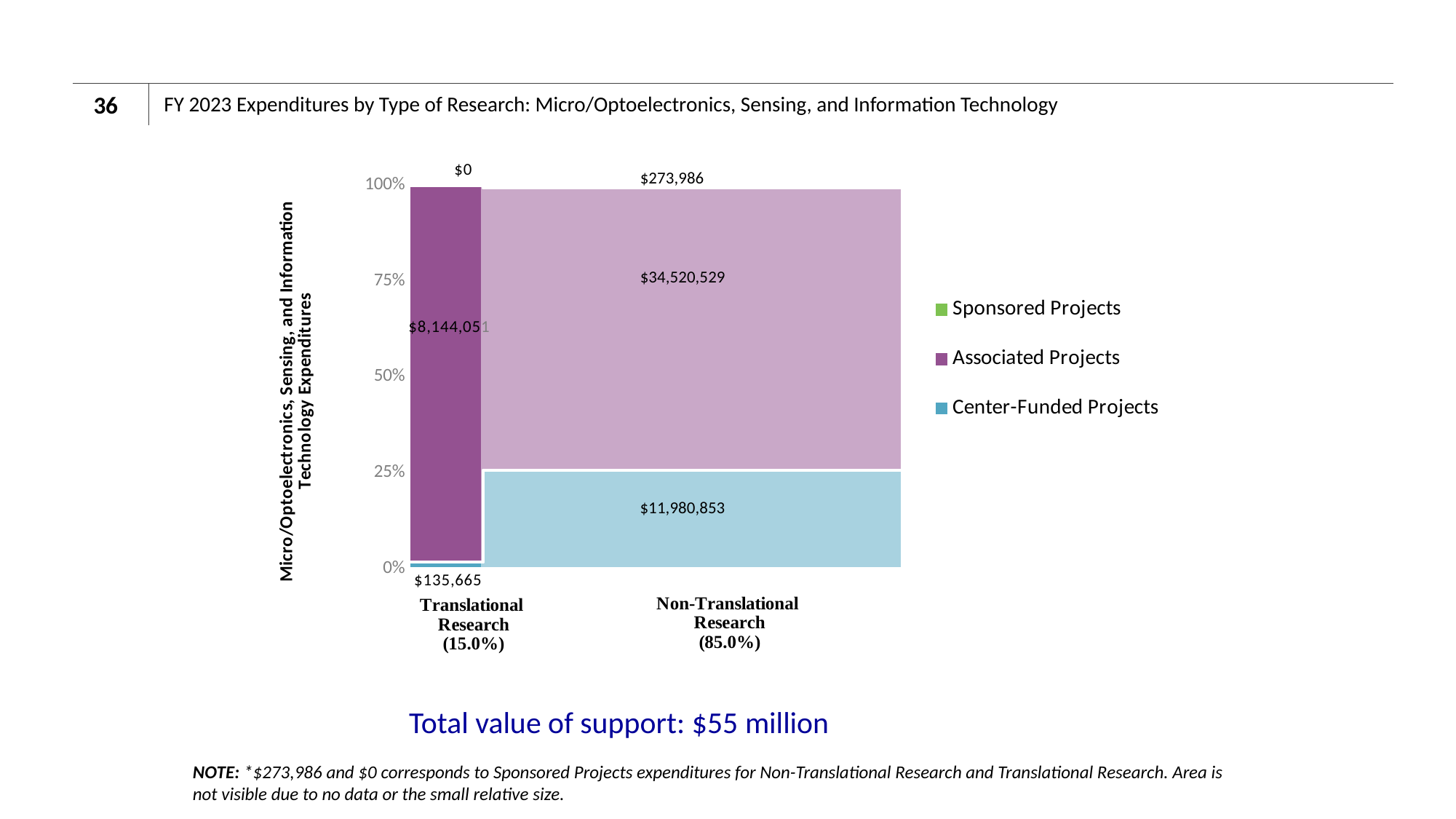
Which category has the larger Center-Funded Projects value, Translational Research or Non-Translational Research? Non-Translational Research What is the Sponsored Projects value for Non-Translational Research? $273,986 What percentage of expenditures does Translational Research account for, as shown in its axis label? 15.0% What is the Associated Projects value for Non-Translational Research? $34,520,529 What is the total of the three series for Non-Translational Research? $46,775,368 What is the difference between the Center-Funded Projects values for Non-Translational Research and Translational Research? $11,845,188 How many research categories are shown on the x axis? 2 What total value of support is stated below the chart? $55 million How many series does the legend list? 3 What is the Center-Funded Projects value for Translational Research? $135,665 What is the Associated Projects value for Translational Research? $8,144,051 What type of chart is shown on the slide? Stacked bar chart